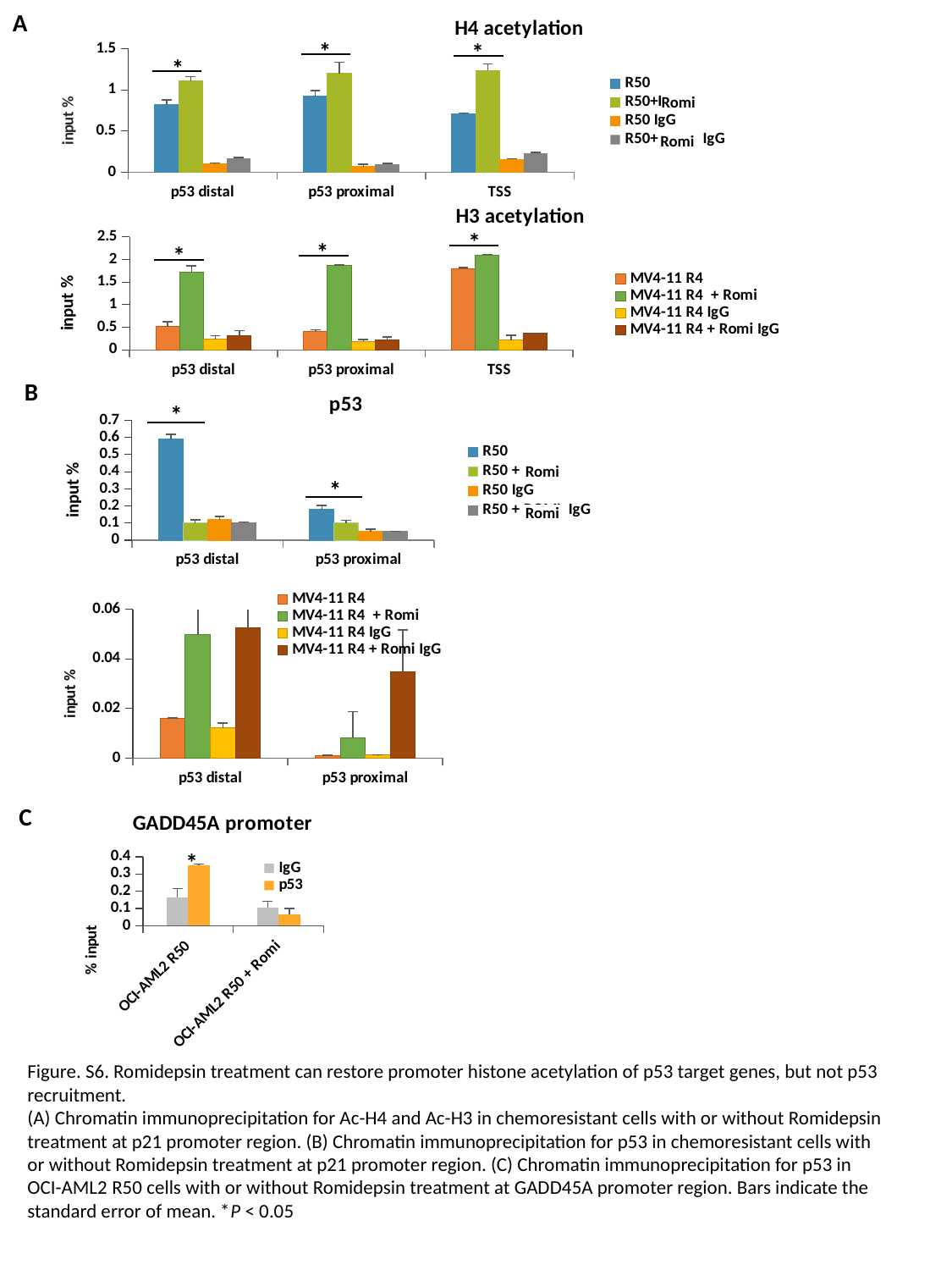
In the H4 acetylation chart, is the value for R50 at p53 distal greater or less than 1? less In the H3 acetylation chart, which is larger at TSS: MV4-11 R4 or MV4-11 R4 + Romi? MV4-11 R4 + Romi What kind of chart is the GADD45A promoter chart? bar chart In the H3 acetylation chart, is the value for MV4-11 R4 + Romi at p53 distal greater or less than 1.5? greater In the H4 acetylation chart, how many categories are shown on the x axis? 3 In the lower chart of panel B (MV4-11 R4 series), is the value for MV4-11 R4 at p53 distal greater or less than 0.02? less In the p53 chart (panel B, top), how many categories are shown on the x axis? 2 In the H4 acetylation chart, which series has the highest bar at p53 proximal? R50+Romi In the GADD45A promoter chart, which is larger for OCI-AML2 R50: IgG or p53? p53 In the H4 acetylation chart, how many series does the legend list? 4